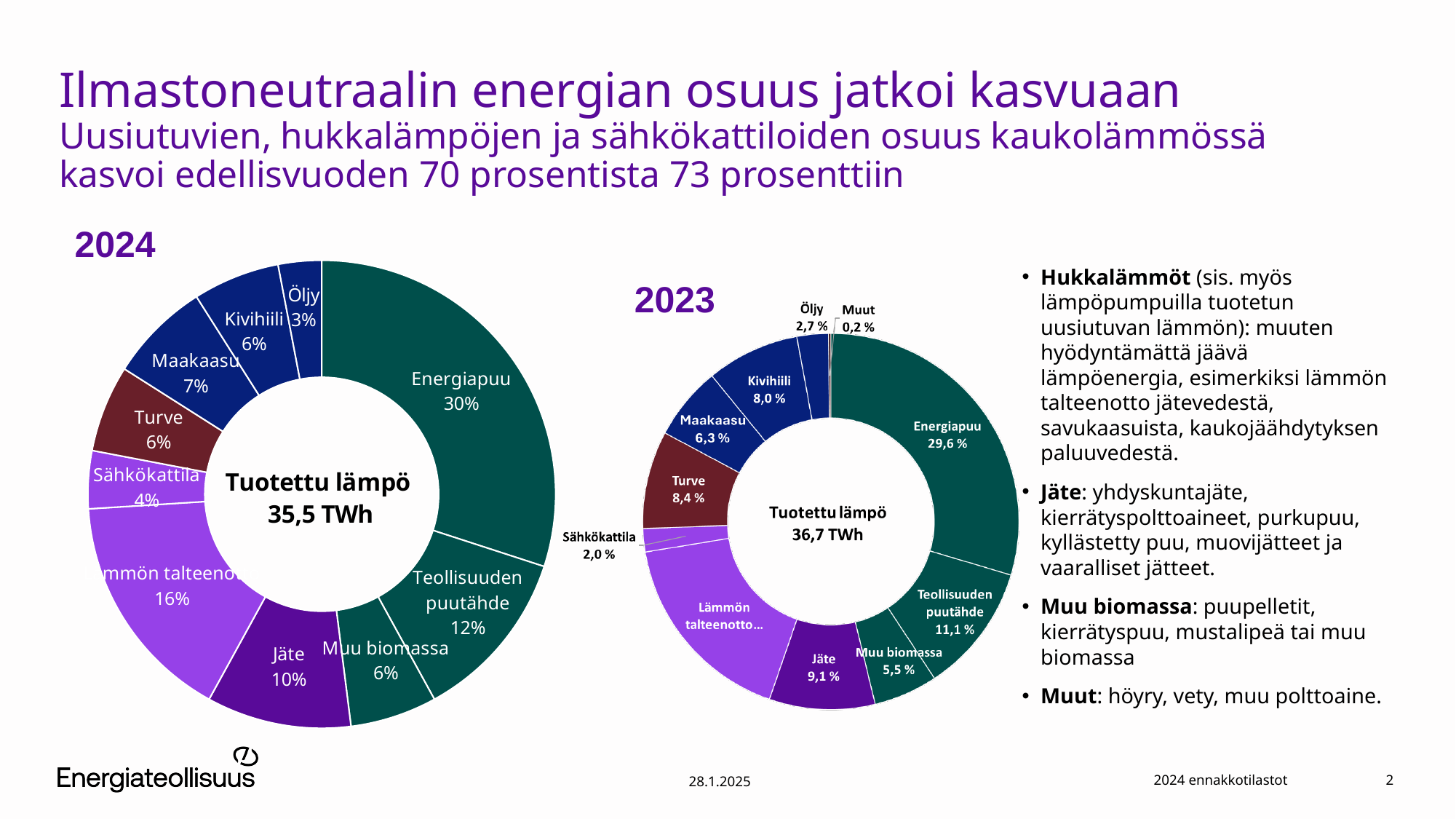
In the 2023 chart, what is the difference between the shares of Kivihiili and Maakaasu? 1,7 % In the 2023 chart, what share does Turve have? 8,4 % In the 2024 chart, which category has the smallest share? Öljy In the 2023 chart, what is the total produced heat shown in the centre? 36,7 TWh In the 2024 chart, what is the difference between the shares of Teollisuuden puutähde and Jäte? 2% In the 2024 chart, what is the total produced heat shown in the centre? 35,5 TWh In the 2024 chart, what share does Energiapuu have? 30% In the 2024 chart, which category has the largest share? Energiapuu How many categories are shown in the 2023 chart? 11 In the 2023 chart, which is larger, the share of Jäte or the share of Muu biomassa? Jäte In the 2023 chart, which category has the smallest share? Muut What type of chart is used for the 2024 data? Doughnut chart